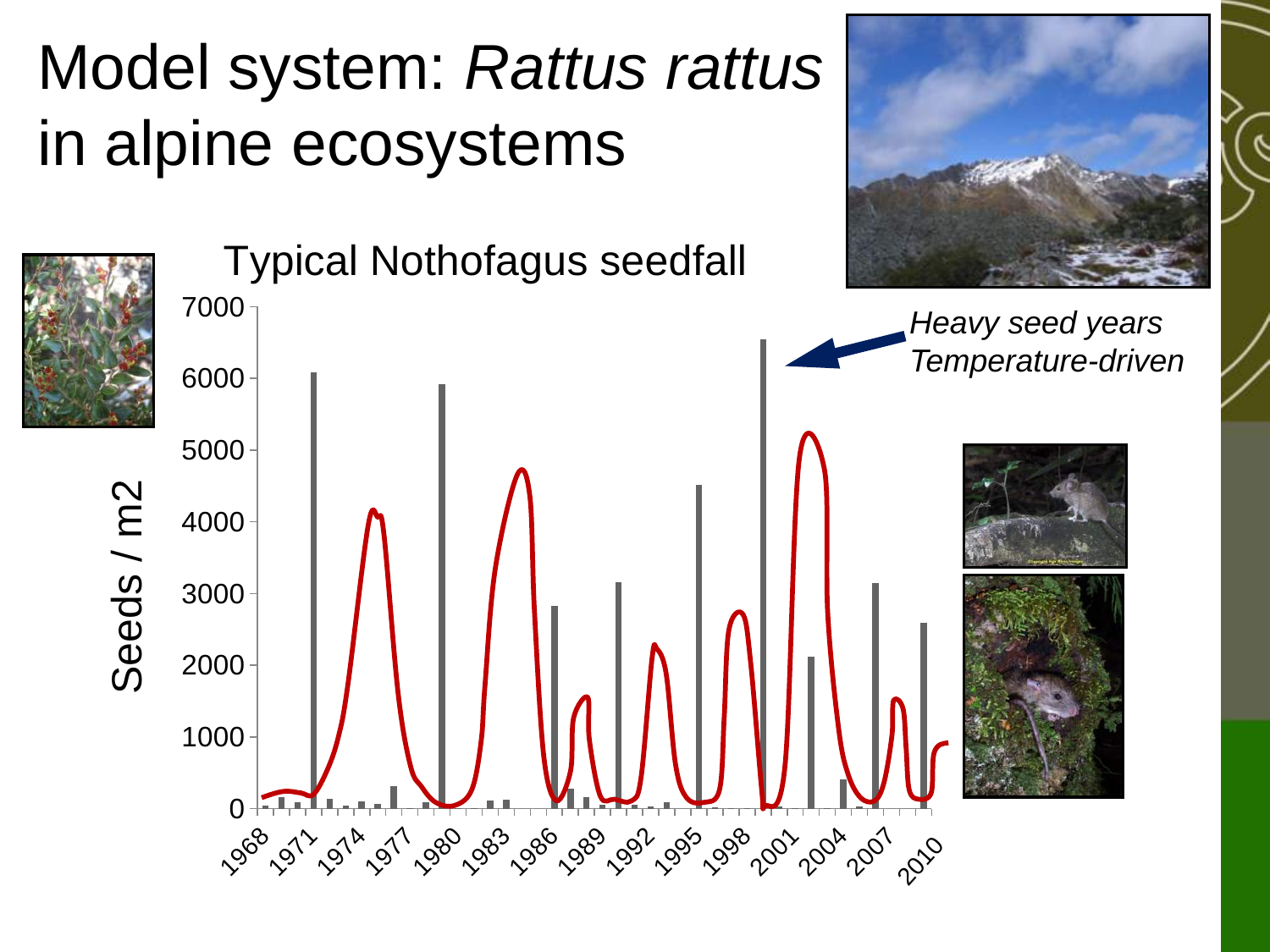
Which year has the tallest bar in the chart? 1999 Is the bar for 1999 greater or less than 6000? greater Is the bar for 2009 greater or less than 3000? less What kind of chart is shown under the title 'Typical Nothofagus seedfall'? bar chart Is the bar for 1995 greater or less than 4000? greater Which bar is taller, 1995 or 2002? 1995 What is the title of the chart? Typical Nothofagus seedfall Which bar is taller, 1971 or 1986? 1971 What is the label on the vertical axis of the chart? Seeds / m2